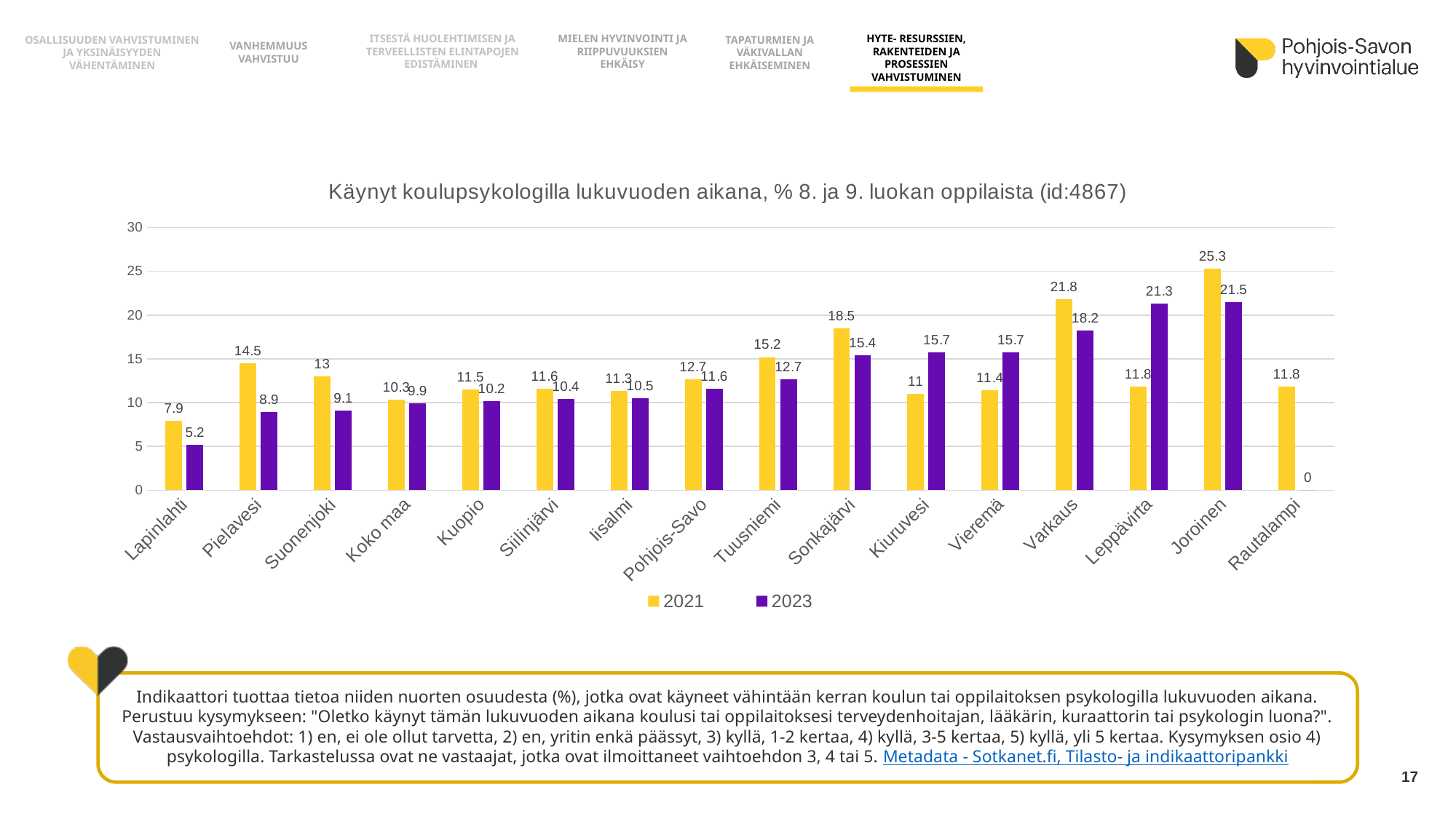
What kind of chart is shown on the slide? bar chart Which category has the highest 2021 value? Joroinen Is the 2021 value for Sonkajärvi greater or less than 15? greater How many categories are shown on the x axis? 16 Which category has the lowest 2023 value? Rautalampi For Leppävirta, which series has the larger value, 2021 or 2023? 2023 What is the difference between the 2021 and 2023 values for Varkaus? 3.6 What is the 2023 value for Lapinlahti? 5.2 How many series does the legend list? 2 What is the difference between the 2021 and 2023 values for Pielavesi? 5.6 What is the 2021 value for Joroinen? 25.3 What is the 2023 value for Koko maa? 9.9